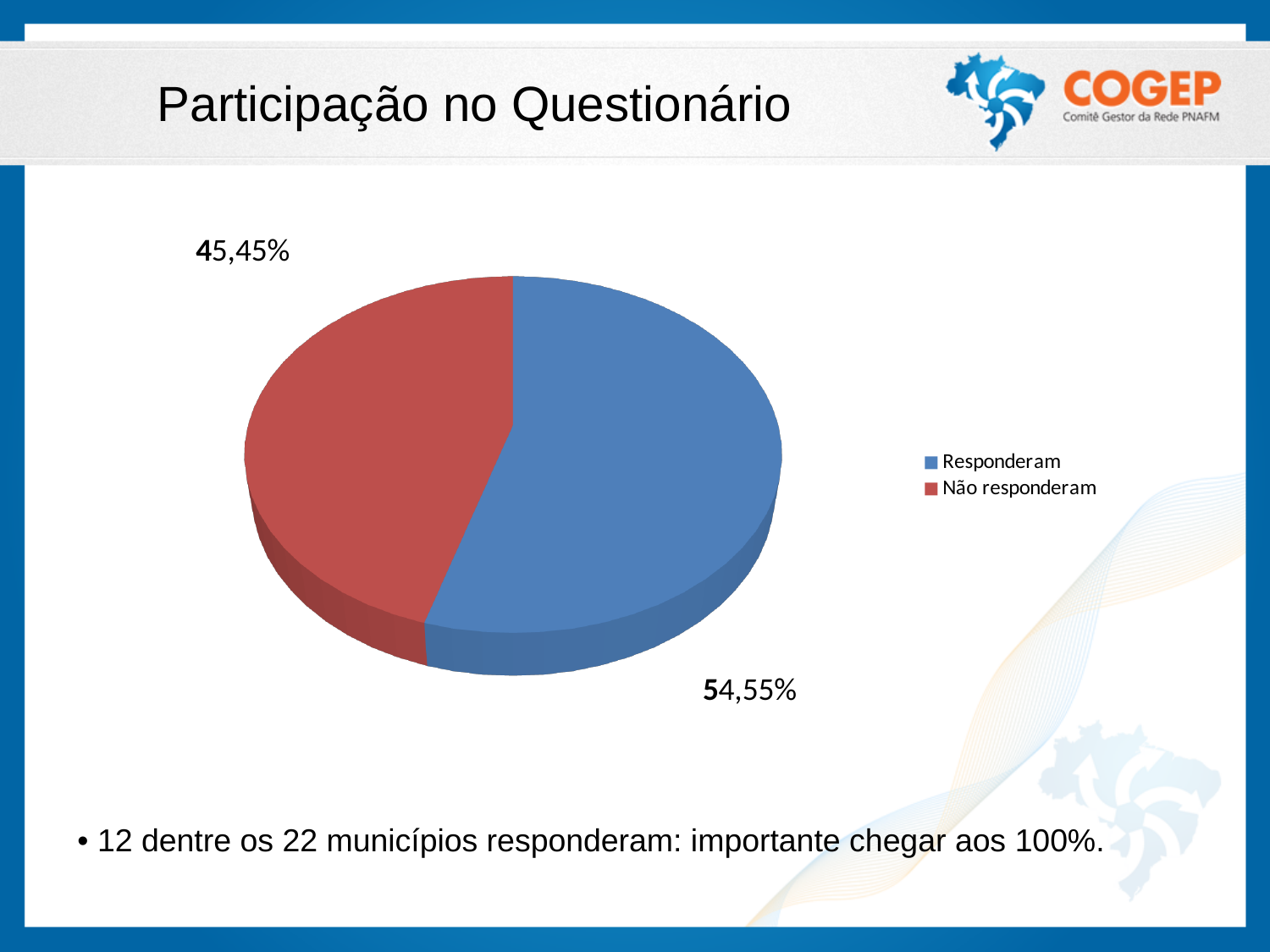
How many slices does the pie chart have? 2 What share of the pie does the "Não responderam" slice represent? 45,45% Which is larger, the "Responderam" slice or the "Não responderam" slice? Responderam Which slice of the pie is the largest? Responderam What colour is the "Não responderam" slice? red Is the value for "Responderam" greater or less than 50%? greater What colour is the "Responderam" slice? blue What share of the pie does the "Responderam" slice represent? 54,55% What kind of chart is shown on the slide? pie chart What is the difference in percentage points between the "Responderam" and "Não responderam" slices? 9,10 percentage points How many entries does the legend list? 2 Which slice of the pie is the smallest? Não responderam